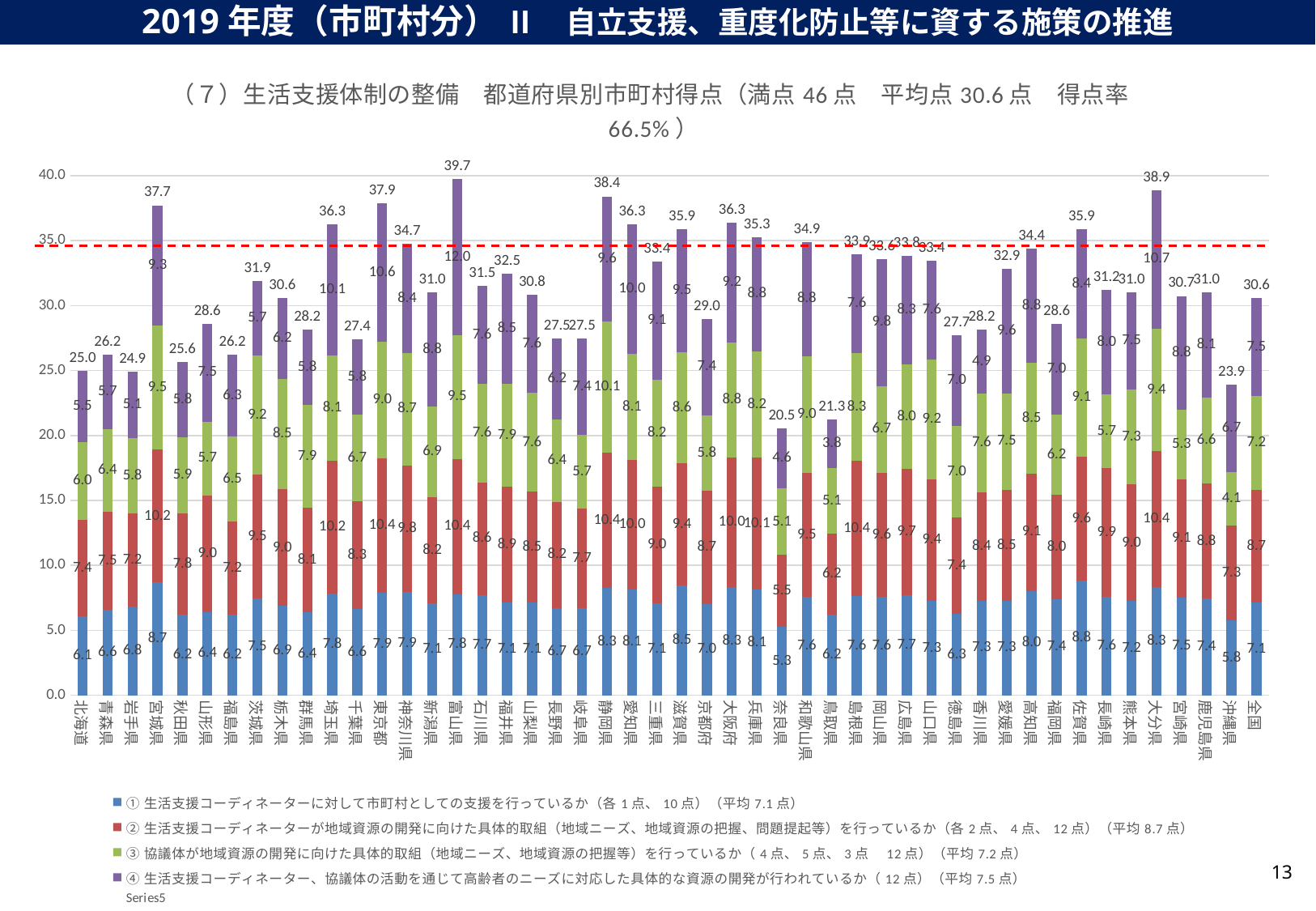
What is the value of the red (②) segment for 全国? 8.7 Which prefecture has the lowest total score? 奈良県 According to the chart title, what is the maximum possible score (満点)? 46 点 What is the value of the blue (①) segment for 北海道? 6.1 Which prefecture has the highest total score? 富山県 What is the total score for 全国? 30.6 What type of chart is shown on the slide? stacked bar chart What is the difference between the total scores of 富山県 and 奈良県? 19.2 How many bars (prefectures plus 全国) are plotted in the chart? 48 Is the total score for 沖縄県 greater or less than 25.0? less Which has a higher total score, 東京都 or 大阪府? 東京都 What is the total score for 宮城県? 37.7